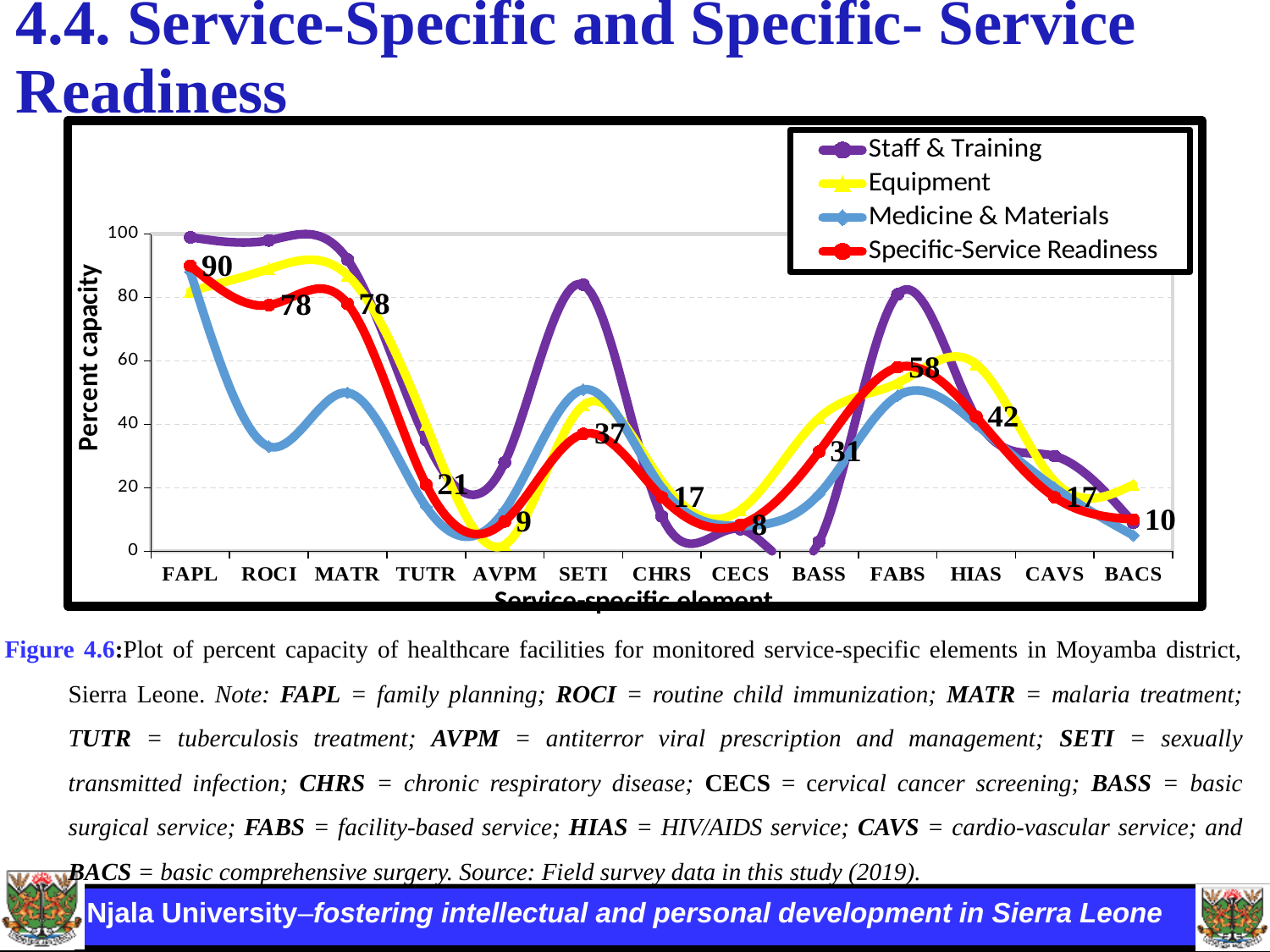
Which has a larger Specific-Service Readiness value, HIAS or BASS? HIAS Which service-specific element has the lowest Specific-Service Readiness value? CECS How many service-specific elements are shown on the x axis? 13 What kind of chart is shown on the slide? Line chart Is the Staff & Training value for FAPL greater or less than 80? greater How many series does the legend list? 4 What is the Specific-Service Readiness value for FAPL? 90 What is the Specific-Service Readiness value for HIAS? 42 Is the Medicine & Materials value for ROCI greater or less than 40? less What is the Specific-Service Readiness value for FABS? 58 Which service-specific element has the highest Specific-Service Readiness value? FAPL What is the difference between the Specific-Service Readiness values for FAPL and FABS? 32